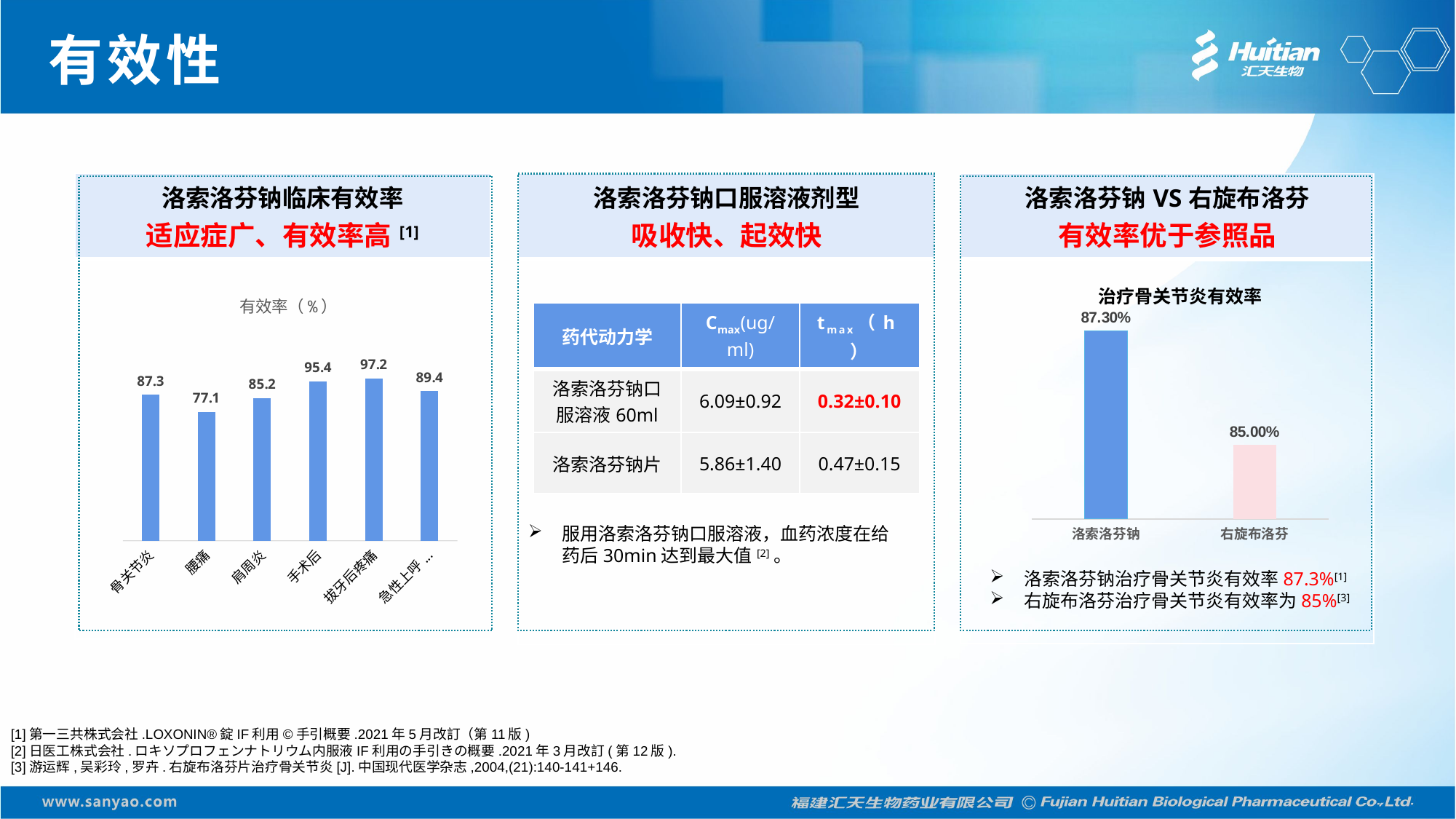
In the right chart titled 治疗骨关节炎有效率, what is the value for 右旋布洛芬? 85.00% In the left chart titled 有效率（%）, what is the difference between the values for 手术后 and 肩周炎? 10.2 In the right chart titled 治疗骨关节炎有效率, what is the difference between the values for 洛索洛芬钠 and 右旋布洛芬? 2.30% In the left chart titled 有效率（%）, which is larger, the value for 骨关节炎 or the value for 肩周炎? 骨关节炎 In the left chart titled 有效率（%）, which category has the lowest value? 腰痛 In the left chart titled 有效率（%）, what is the value for 腰痛? 77.1 In the right chart titled 治疗骨关节炎有效率, what is the value for 洛索洛芬钠? 87.30% What kind of chart is the left chart titled 有效率（%）? bar chart In the left chart titled 有效率（%）, what is the value for 骨关节炎? 87.3 How many categories are shown in the left chart titled 有效率（%）? 6 In the left chart titled 有效率（%）, what is the value for 拔牙后疼痛? 97.2 In the left chart titled 有效率（%）, which category has the highest value? 拔牙后疼痛